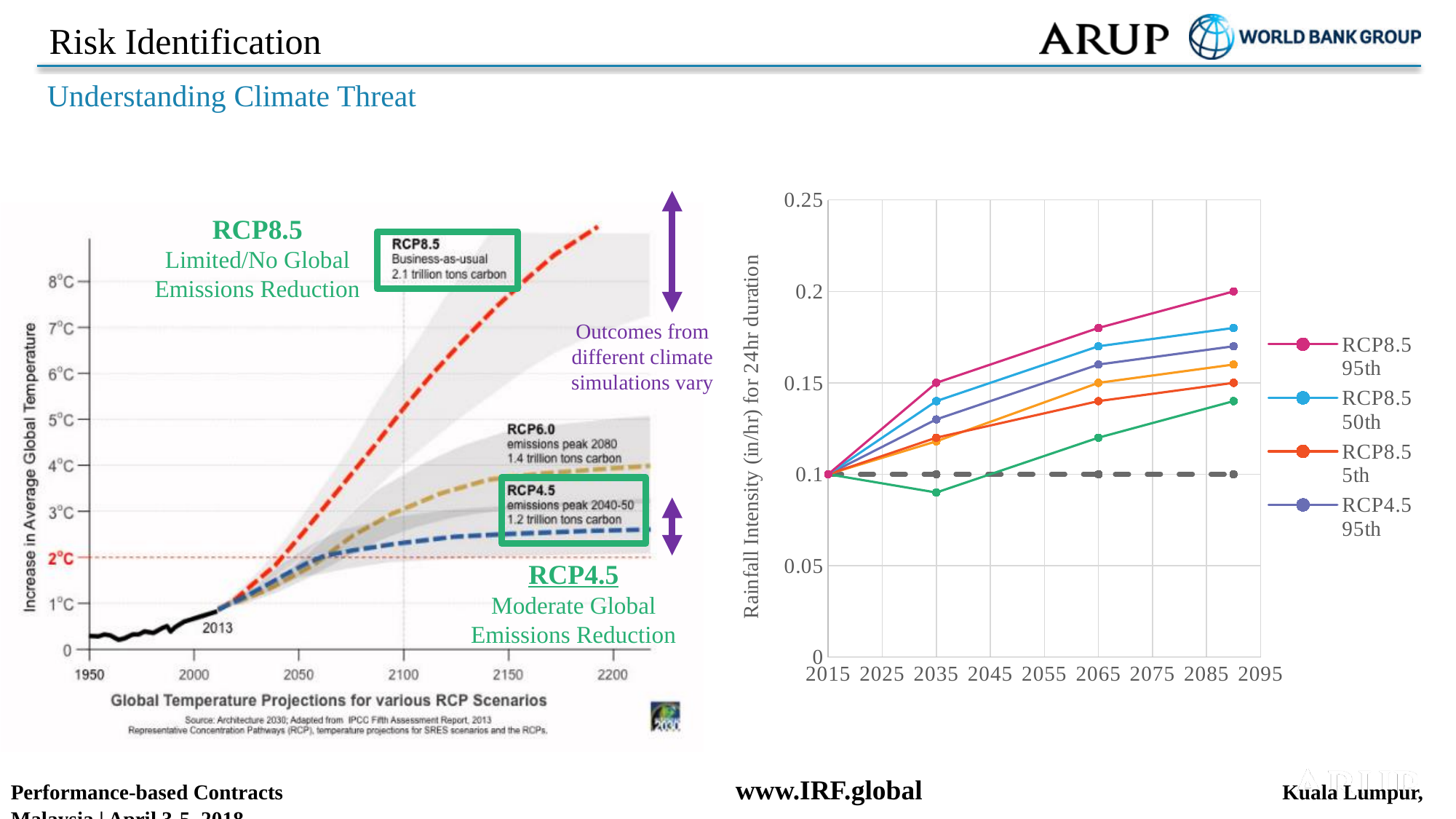
In the left-hand temperature projections chart, which RCP scenario reaches the highest temperature increase? RCP8.5 In the right-hand rainfall intensity chart, is the value for RCP8.5 5th in 2035 greater or less than 0.15? less In the right-hand rainfall intensity chart, which legend series has the highest value at the last plotted year? RCP8.5 95th In the right-hand rainfall intensity chart, what is the value for RCP8.5 95th in 2015? 0.1 In the right-hand rainfall intensity chart, what is the y-axis label? Rainfall Intensity (in/hr) for 24hr duration In the right-hand rainfall intensity chart, does the RCP8.5 95th series rise or fall from 2015 to the last plotted year? rise In the right-hand rainfall intensity chart, is the value for RCP8.5 50th at the last plotted year greater or less than 0.15? greater In the right-hand rainfall intensity chart, what is the value for RCP8.5 95th at the last plotted year (around 2090)? 0.2 In the left-hand chart, what is the title printed below the plot? Global Temperature Projections for various RCP Scenarios In the right-hand rainfall intensity chart, what is the value for RCP8.5 95th in 2035? 0.15 What kind of chart is the right-hand chart showing rainfall intensity? line chart In the right-hand rainfall intensity chart, how many series does the legend list? 4